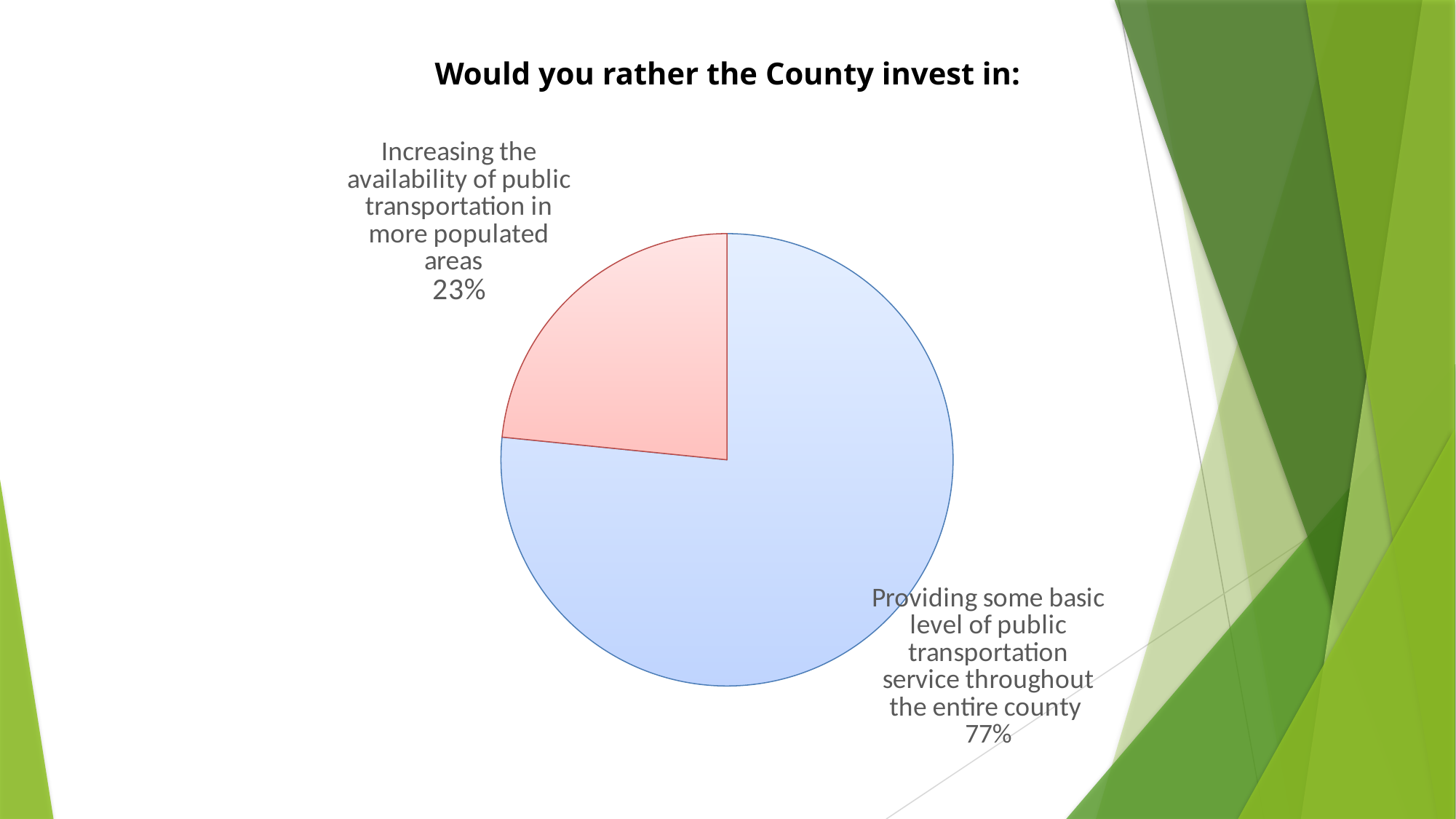
What is the chart's title? Would you rather the County invest in: Which option has the smallest share of the pie? Increasing the availability of public transportation in more populated areas What share of the pie is 'Providing some basic level of public transportation service throughout the entire county'? 77% Which option has the largest share of the pie? Providing some basic level of public transportation service throughout the entire county What share of the pie is 'Increasing the availability of public transportation in more populated areas'? 23% What is the difference in percentage points between the two slices? 54 What kind of chart is shown on the slide? pie chart How many slices does the pie chart have? 2 Which is larger: the share for 'Increasing the availability of public transportation in more populated areas' or the share for 'Providing some basic level of public transportation service throughout the entire county'? Providing some basic level of public transportation service throughout the entire county What colour is the slice for 'Increasing the availability of public transportation in more populated areas'? pink